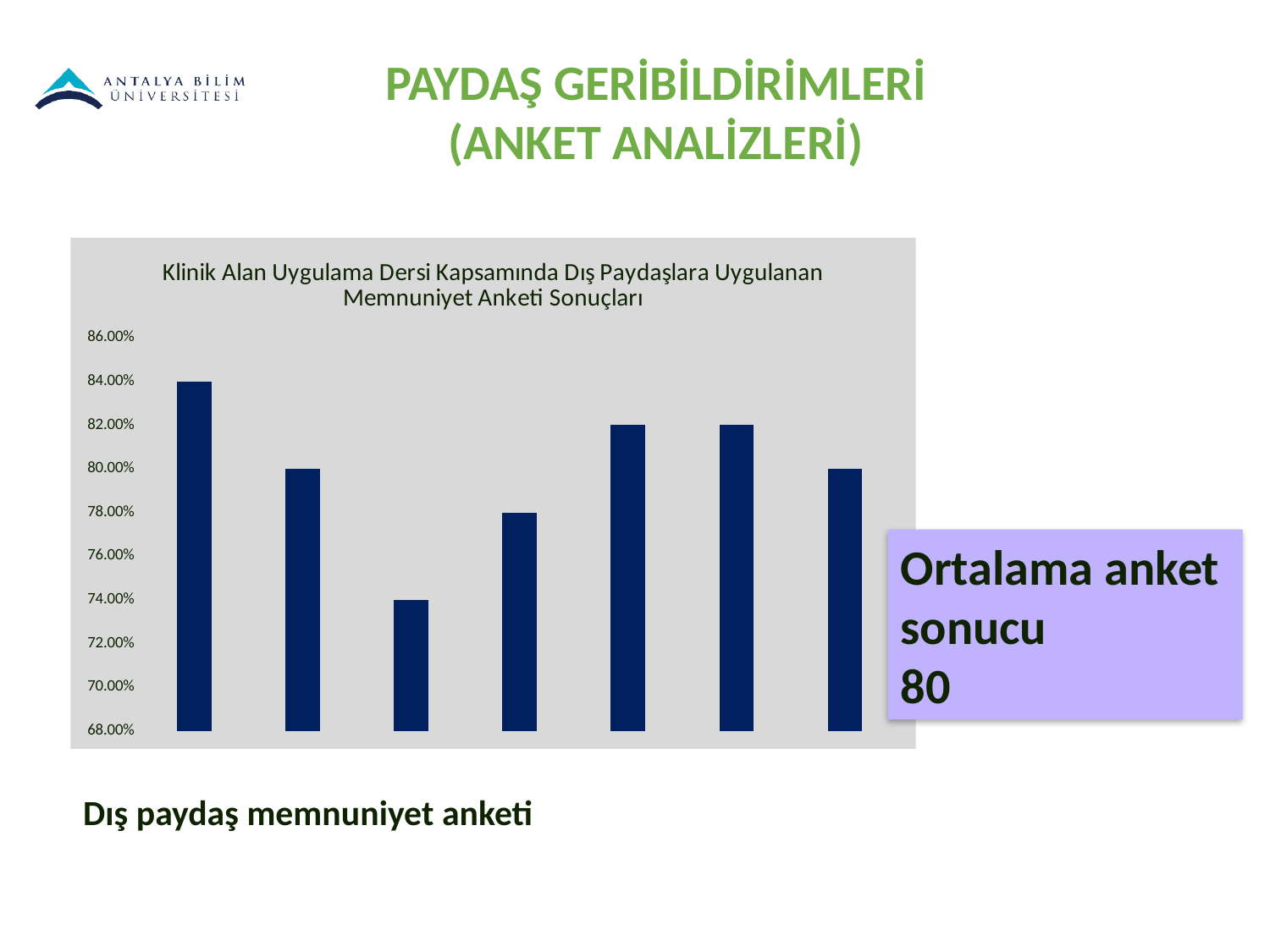
How many bars are plotted in the chart? 7 Is the value of the fourth bar from the left greater or less than 80.00%? less What is the title of the chart? Klinik Alan Uygulama Dersi Kapsamında Dış Paydaşlara Uygulanan Memnuniyet Anketi Sonuçları What kind of chart is shown on the slide? bar chart Which is larger, the value of the first bar or the value of the second bar from the left? the first bar Is the value of the third bar from the left greater or less than 76.00%? less Which bar is the shortest in the chart, counting from the left? the third bar What is the lowest value shown on the vertical axis of the chart? 68.00% Which bar is the tallest in the chart, counting from the left? the first bar Which is larger, the value of the third bar or the value of the fifth bar from the left? the fifth bar Is the value of the first bar from the left greater or less than 82.00%? greater